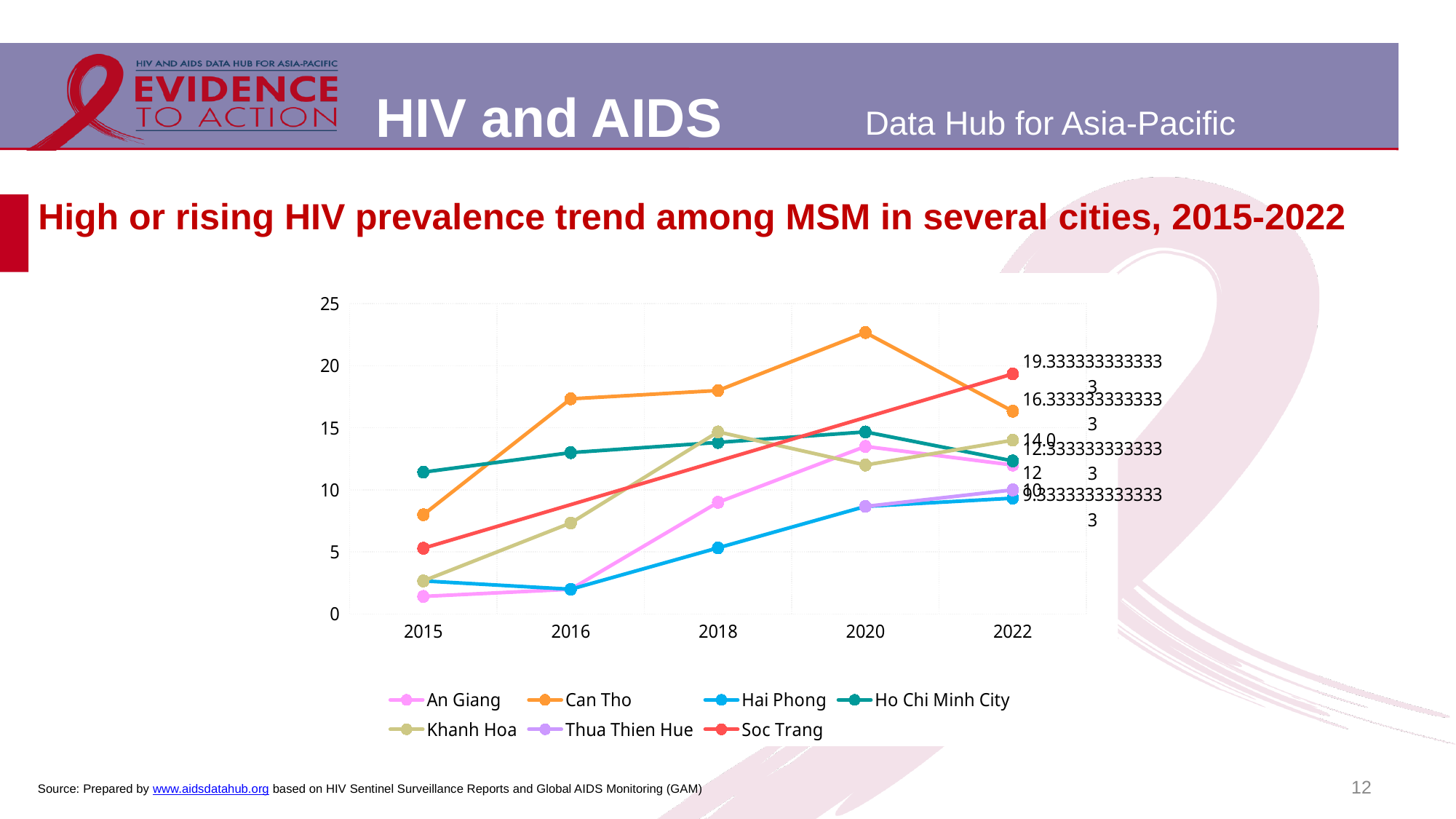
Which city has the highest HIV prevalence in 2020? Can Tho Is the value for Can Tho in 2020 greater or less than 20? greater Which city has the highest HIV prevalence in 2022? Soc Trang How many series does the legend list? 7 Is the value for Hai Phong in 2016 greater or less than 5? less What type of chart is shown on the slide? line chart What is the data label shown for Soc Trang in 2022? 19.3333333333333 Does the Soc Trang line rise or fall from 2015 to 2022? rises In 2015, which is higher: Ho Chi Minh City or Hai Phong? Ho Chi Minh City How many years are shown on the x axis? 5 What is the title of the chart? High or rising HIV prevalence trend among MSM in several cities, 2015-2022 Which city has the lowest HIV prevalence in 2015? An Giang